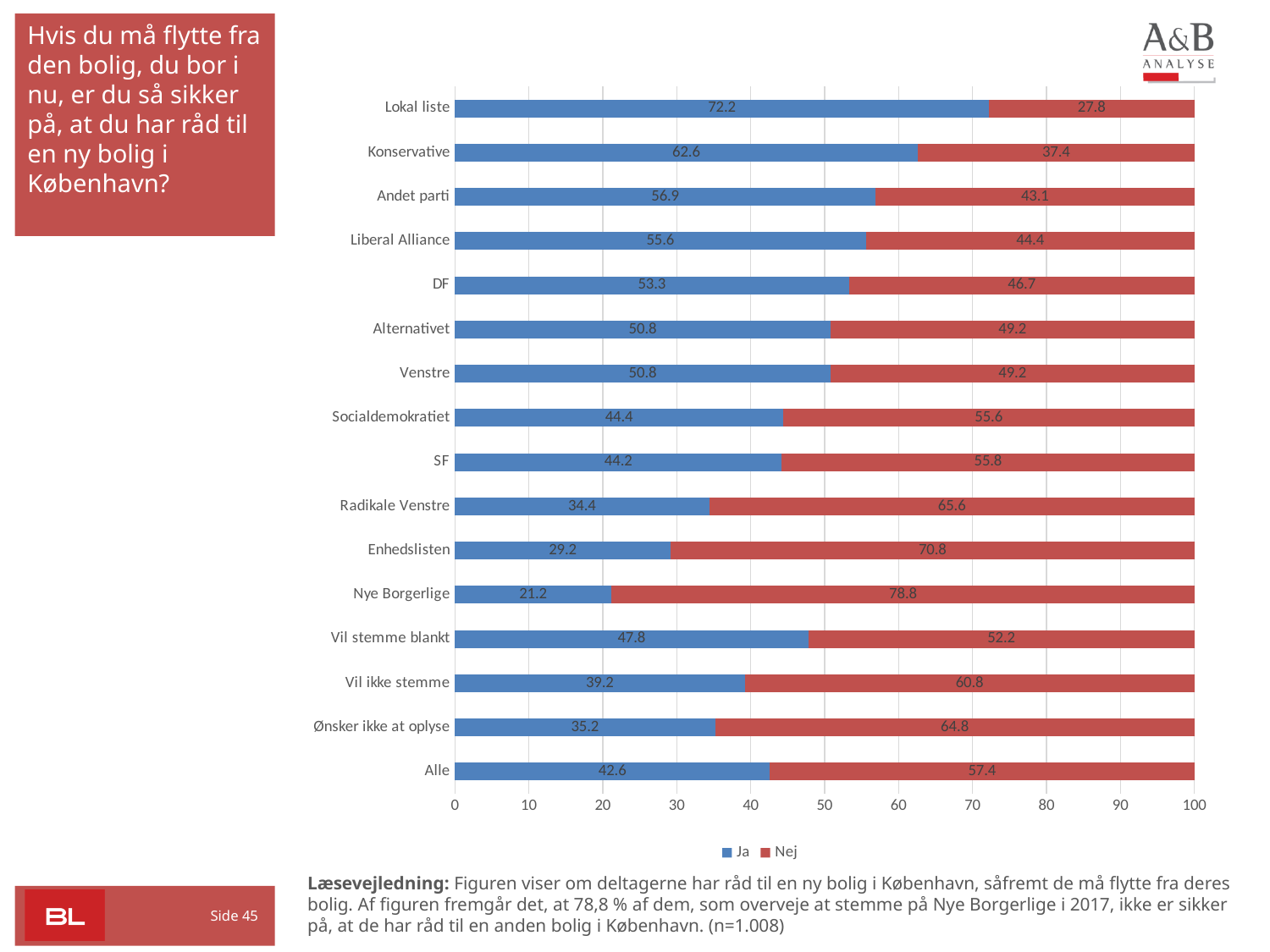
Which colour represents the "Nej" series? red What kind of chart is shown? stacked bar chart How many categories are shown on the y axis? 16 Which category has the highest "Ja" value? Lokal liste Which category has the lowest "Ja" value? Nye Borgerlige What is the "Ja" value for Lokal liste? 72.2 What is the "Nej" value for Nye Borgerlige? 78.8 What is the total of the stacked bar for SF? 100 How many series does the legend list? 2 What is the "Ja" value for Alle? 42.6 Which is larger: the "Ja" value for Radikale Venstre or the "Ja" value for Vil ikke stemme? Vil ikke stemme What is the difference between the "Nej" value for Enhedslisten and the "Nej" value for Konservative? 33.4